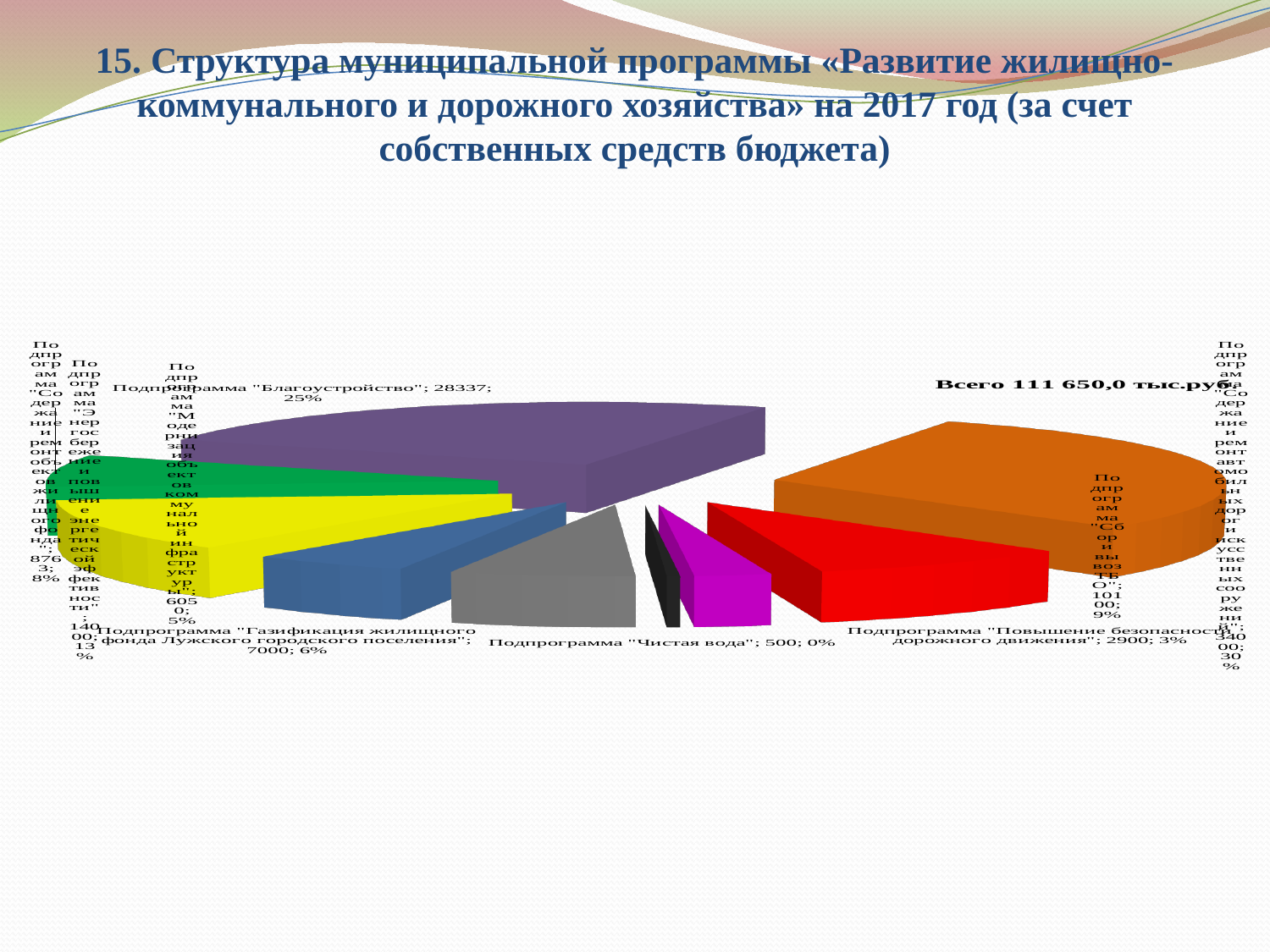
What kind of chart is shown on the slide? pie chart Which is larger: Подпрограмма "Благоустройство" or Подпрограмма "Газификация жилищного фонда Лужского городского поселения"? Подпрограмма "Благоустройство" What value is shown for Подпрограмма "Газификация жилищного фонда Лужского городского поселения"? 7000 What total amount is stated on the chart? Всего 111 650,0 тыс.руб. What share of the pie does Подпрограмма "Благоустройство" have? 25% What value is shown for Подпрограмма "Повышение безопасности дорожного движения"? 2900 Which slice is the smallest in the pie chart? Подпрограмма "Чистая вода" What value is shown for Подпрограмма "Благоустройство"? 28337 What is the difference between the values for Подпрограмма "Благоустройство" and Подпрограмма "Газификация жилищного фонда Лужского городского поселения"? 21337 What share of the pie does Подпрограмма "Газификация жилищного фонда Лужского городского поселения" have? 6% What share of the pie does Подпрограмма "Повышение безопасности дорожного движения" have? 3% What value is shown for Подпрограмма "Чистая вода"? 500